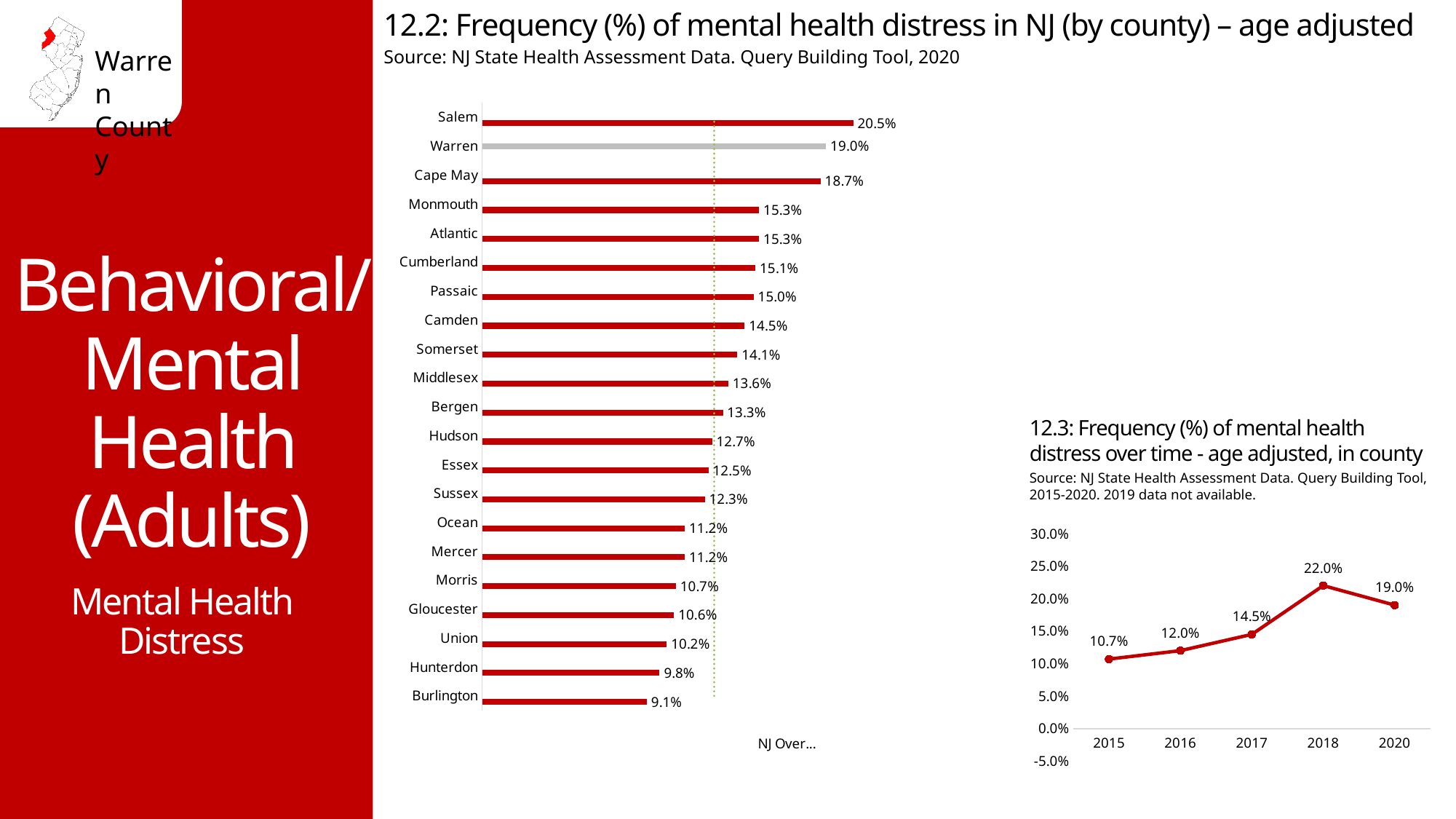
What kind of chart is chart 12.3 (mental health distress over time)? Line chart In chart 12.2 (frequency of mental health distress by county), what is the value for Warren? 19.0% In chart 12.2 (frequency of mental health distress by county), which county has the highest value? Salem In chart 12.3 (mental health distress over time), what is the value for 2018? 22.0% In chart 12.2 (frequency of mental health distress by county), what is the value for Hunterdon? 9.8% In chart 12.2 (frequency of mental health distress by county), what is the difference between Salem and Burlington? 11.4% In chart 12.2 (frequency of mental health distress by county), how many counties are shown? 21 What kind of chart is chart 12.2 (frequency of mental health distress by county)? Bar chart In chart 12.2 (frequency of mental health distress by county), which county has the lowest value? Burlington In chart 12.2 (frequency of mental health distress by county), which is larger, the value for Cape May or the value for Monmouth? Cape May In chart 12.3 (mental health distress over time), which year has the lowest value? 2015 In chart 12.3 (mental health distress over time), what is the difference between the 2018 and 2020 values? 3.0%